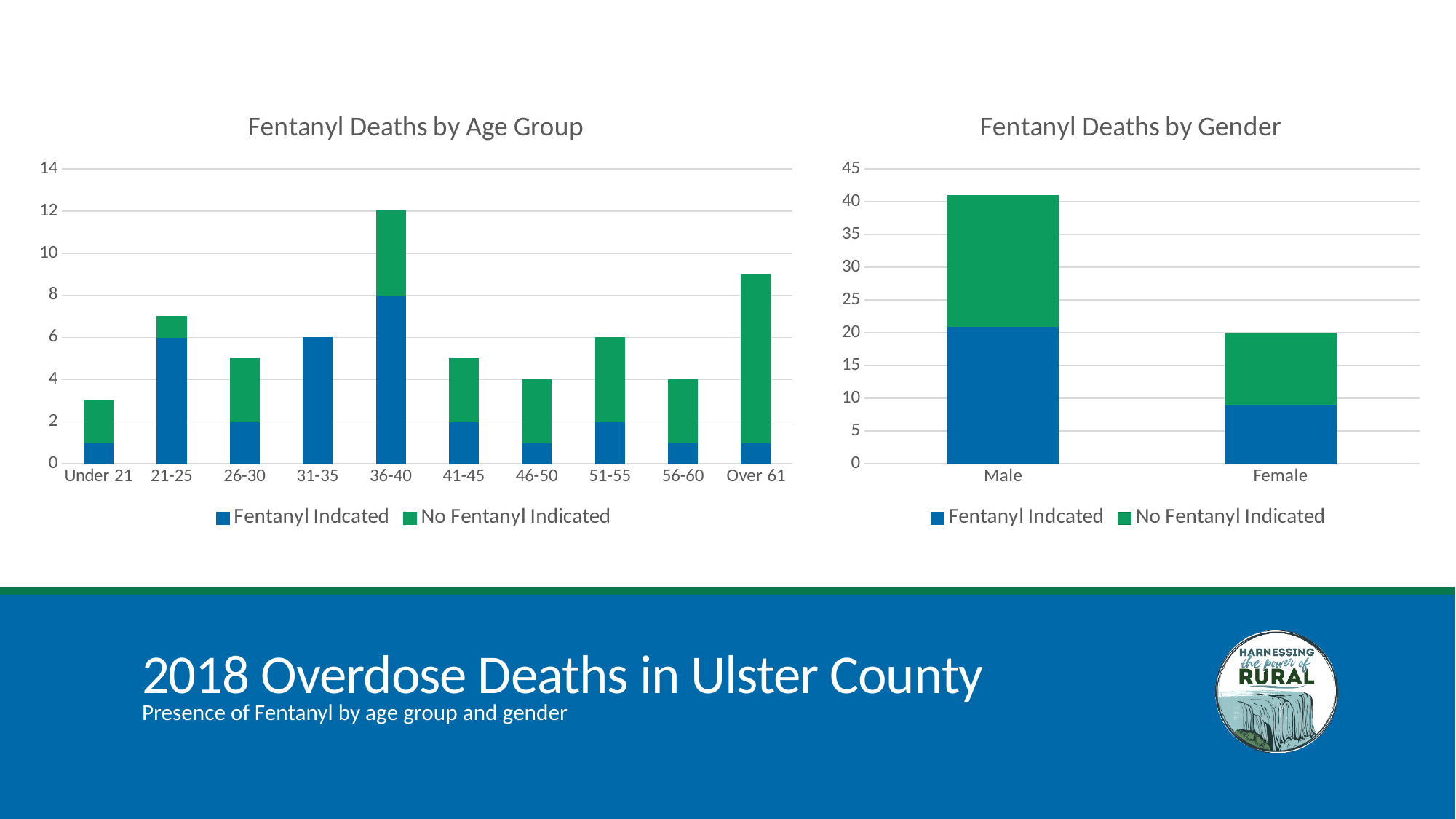
In the 'Fentanyl Deaths by Age Group' chart, what is the total height of the stacked bar for the 36-40 age group? 12 How many series does the legend of the 'Fentanyl Deaths by Gender' chart list? 2 In the 'Fentanyl Deaths by Gender' chart, which category has the larger total bar, Male or Female? Male In the 'Fentanyl Deaths by Gender' chart, is the total value for Male greater or less than 35? greater In the 'Fentanyl Deaths by Age Group' chart, which age group has the lowest total bar? Under 21 In the 'Fentanyl Deaths by Gender' chart, what is the total height of the stacked bar for Female? 20 In the 'Fentanyl Deaths by Age Group' chart, what is the Fentanyl Indicated value for the 36-40 age group? 8 In the 'Fentanyl Deaths by Age Group' chart, is the total value for Over 61 greater or less than 8? greater How many age groups are shown on the 'Fentanyl Deaths by Age Group' chart? 10 What kind of chart is the 'Fentanyl Deaths by Age Group' chart? Stacked bar chart In the 'Fentanyl Deaths by Age Group' chart, what is the Fentanyl Indicated value for the 21-25 age group? 6 In the 'Fentanyl Deaths by Age Group' chart, which age group has the highest total bar? 36-40